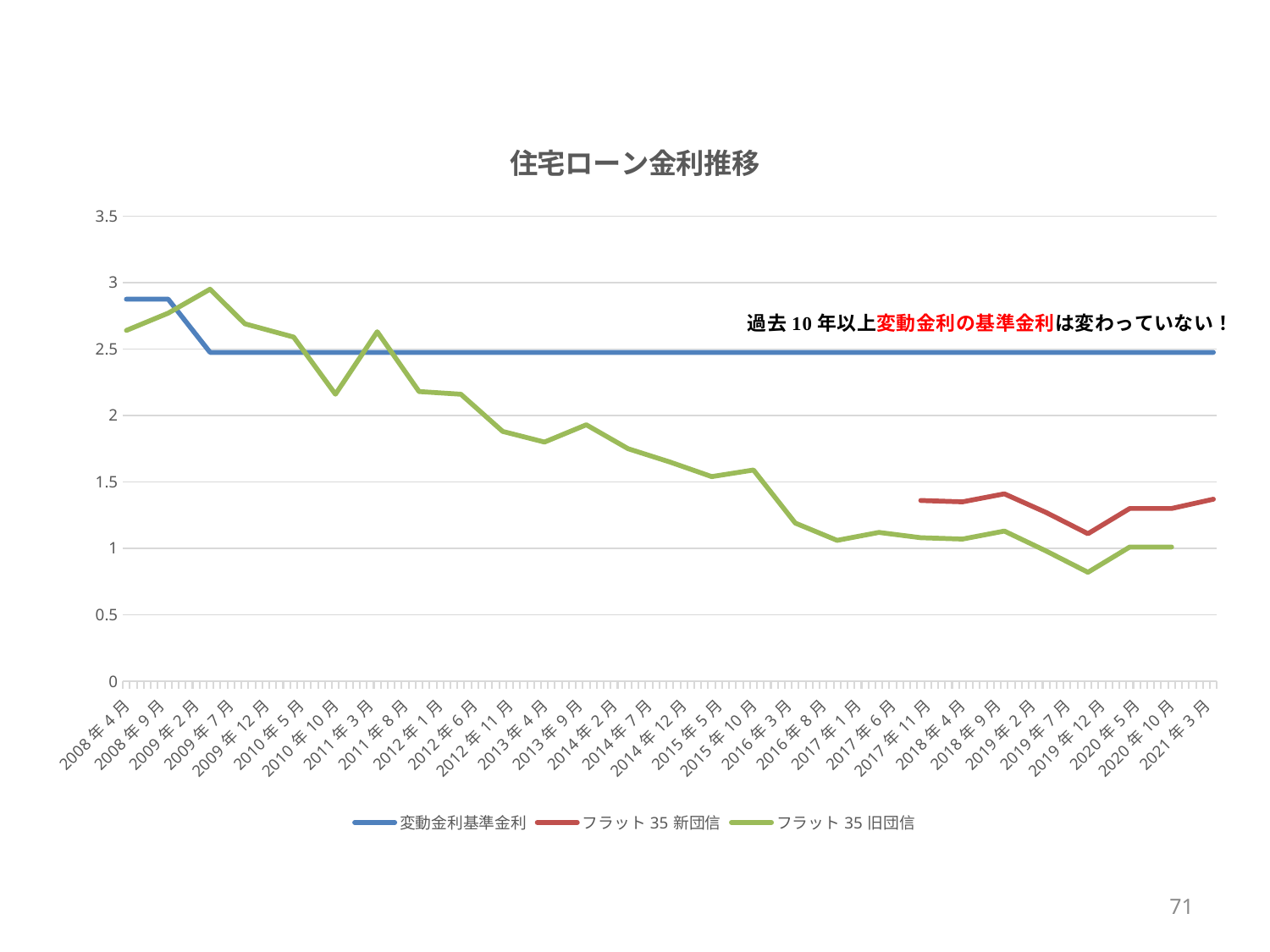
Which series is drawn in blue according to the legend? 変動金利基準金利 Is the value for フラット35 旧団信 at 2009年2月 greater or less than 2.5? greater How many series does the legend list? 3 What kind of chart is shown on the slide? line chart Which series has the highest value at 2021年3月? 変動金利基準金利 What is the title of the chart? 住宅ローン金利推移 Is the value for フラット35 旧団信 at 2019年12月 greater or less than 1? less Is the value for フラット35 新団信 at 2017年11月 greater or less than 1? greater Does the フラット35 旧団信 line generally rise or fall from 2008年4月 to 2021年3月? fall